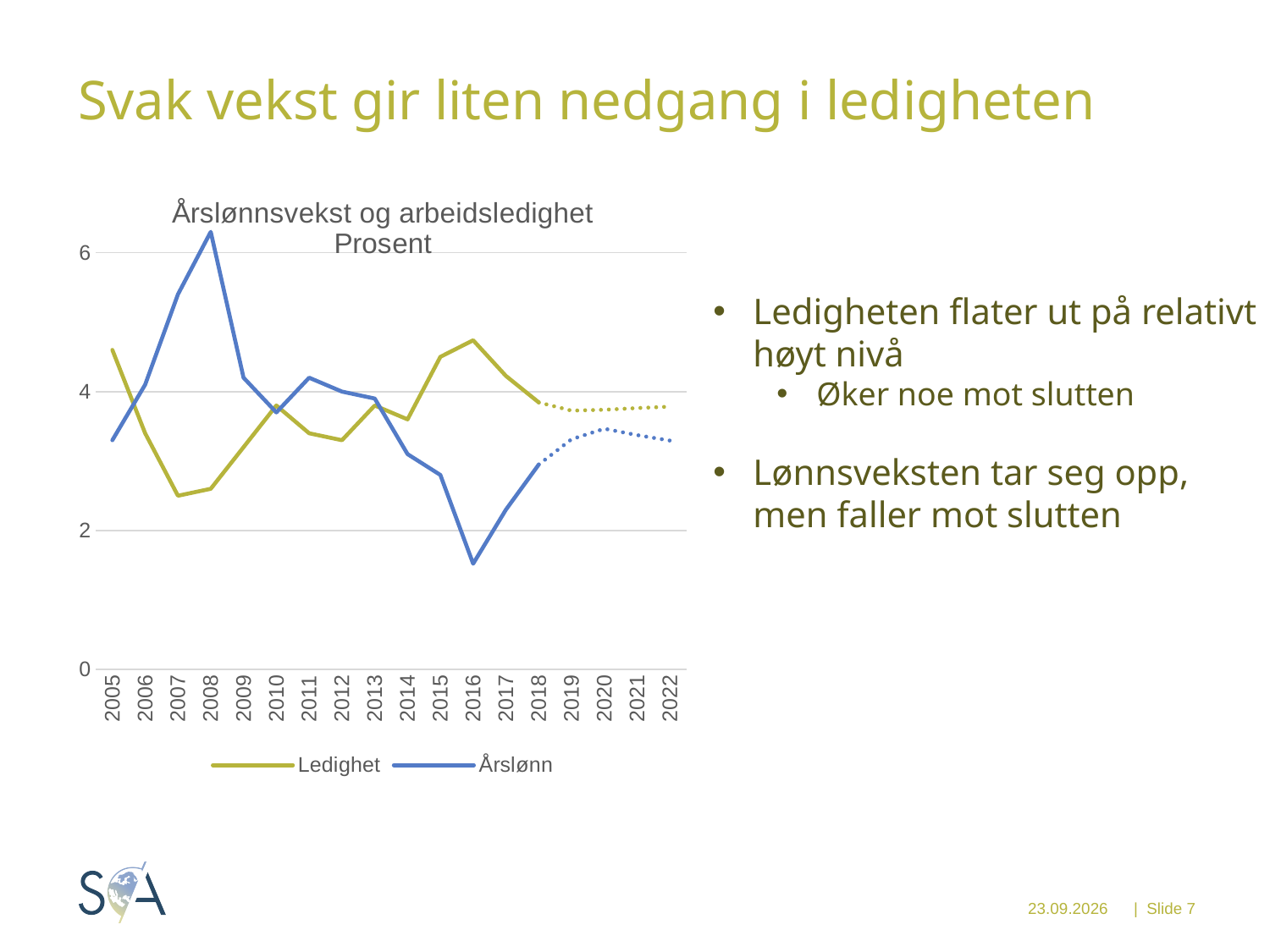
How many series does the chart legend list? 2 Is the value for Ledighet in 2012 greater or less than 4? less Is the value for Ledighet in 2016 greater or less than 4? greater In which year does the Ledighet series reach its lowest value? 2007 In which year does the Årslønn series reach its highest value? 2008 What is the title of the chart? Årslønnsvekst og arbeidsledighet Prosent What kind of chart is shown on the slide? line chart How many years are shown on the x axis of the chart? 18 In which year does the Årslønn series reach its lowest value? 2016 Is the value for Årslønn in 2016 greater or less than 2? less In 2008, which series has the larger value, Ledighet or Årslønn? Årslønn Does the Årslønn series rise or fall from 2005 to 2008? rise